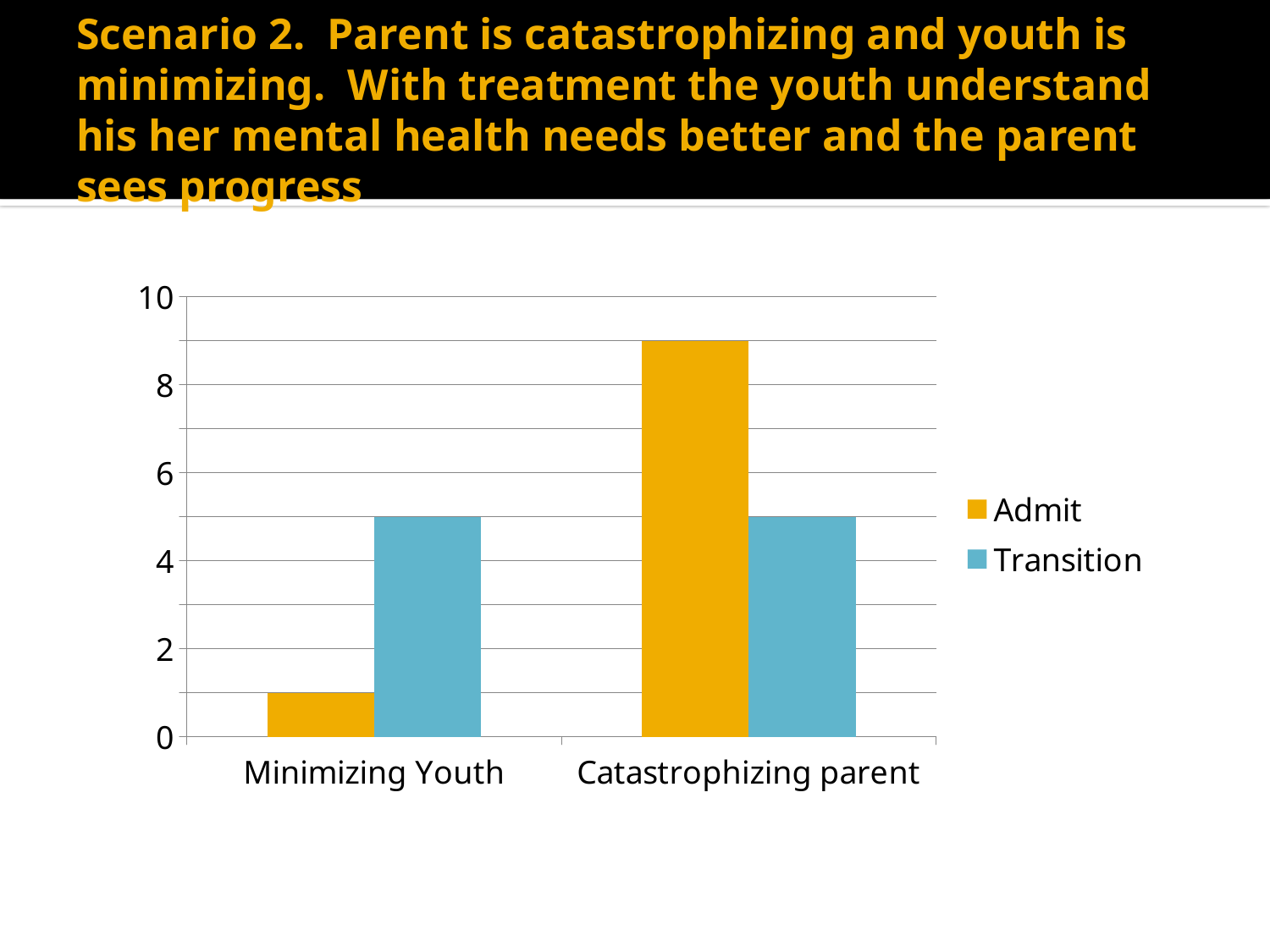
Which category has the higher Admit value? Catastrophizing parent Is the Transition value for Catastrophizing parent greater or less than 6? less What kind of chart is shown on the slide? bar chart Is the Admit value for Catastrophizing parent greater or less than 8? greater Which colour represents the Admit series in the chart? yellow/orange How many series does the chart's legend list? 2 Is the Transition value for Minimizing Youth greater or less than 4? greater How many categories are shown on the x axis of the chart? 2 For Minimizing Youth, which is larger: the Admit value or the Transition value? Transition For Catastrophizing parent, which is larger: the Admit value or the Transition value? Admit What are the two series named in the chart's legend? Admit and Transition